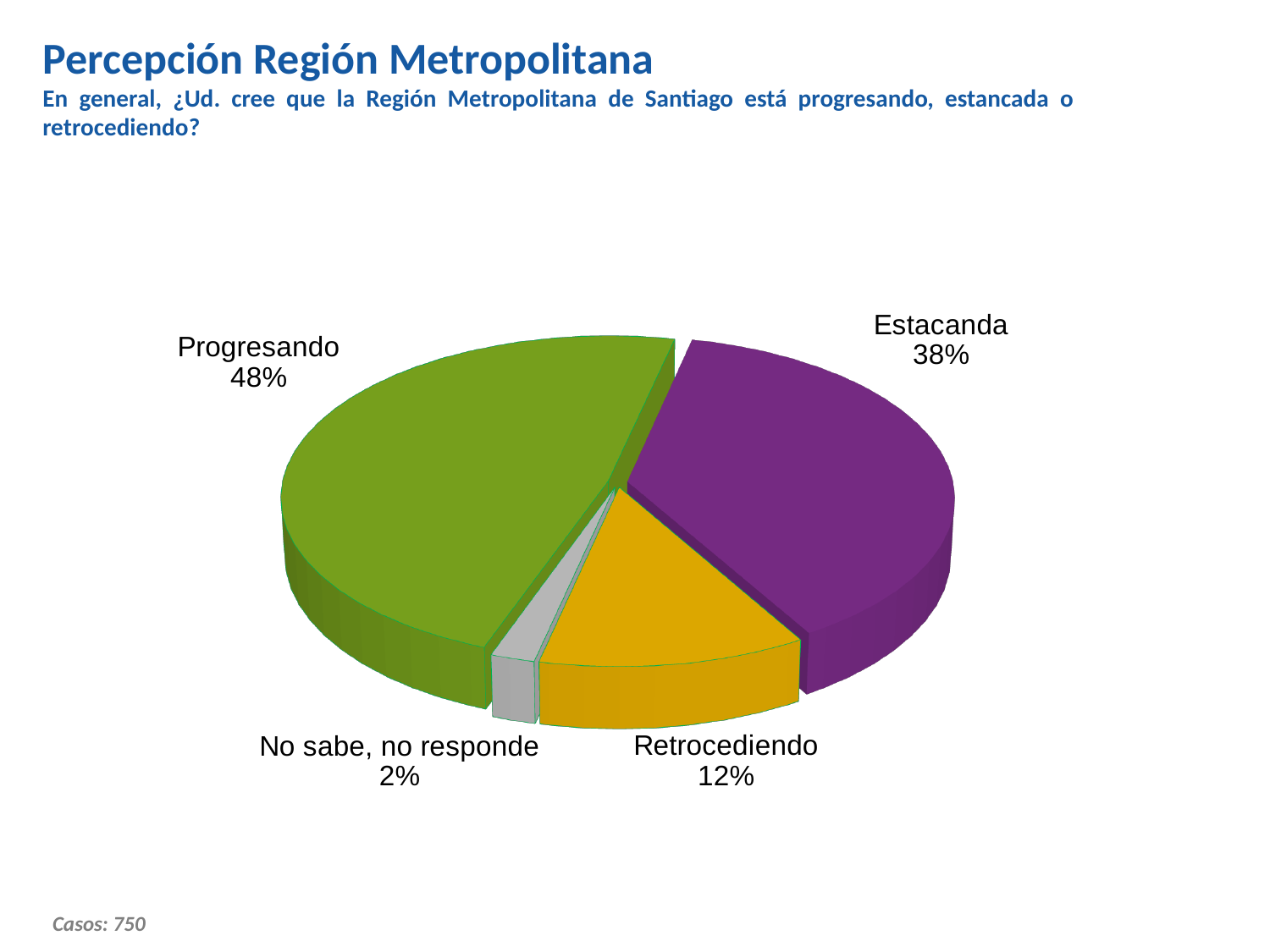
What kind of chart is shown on the slide? Pie chart Which response has the smallest share of the pie? No sabe, no responde What is the difference in percentage points between "Retrocediendo" and "No sabe, no responde"? 10 What percentage of respondents answered "Progresando"? 48% Which response has the largest share of the pie? Progresando What percentage of respondents answered "Retrocediendo"? 12% How many slices does the pie chart have? 4 What is the difference in percentage points between "Progresando" and "Estacanda"? 10 Which is larger, the share for "Estacanda" or the share for "Retrocediendo"? Estacanda What percentage of respondents answered "Estacanda"? 38% What percentage of respondents answered "No sabe, no responde"? 2% What colour is the "Progresando" slice? Green